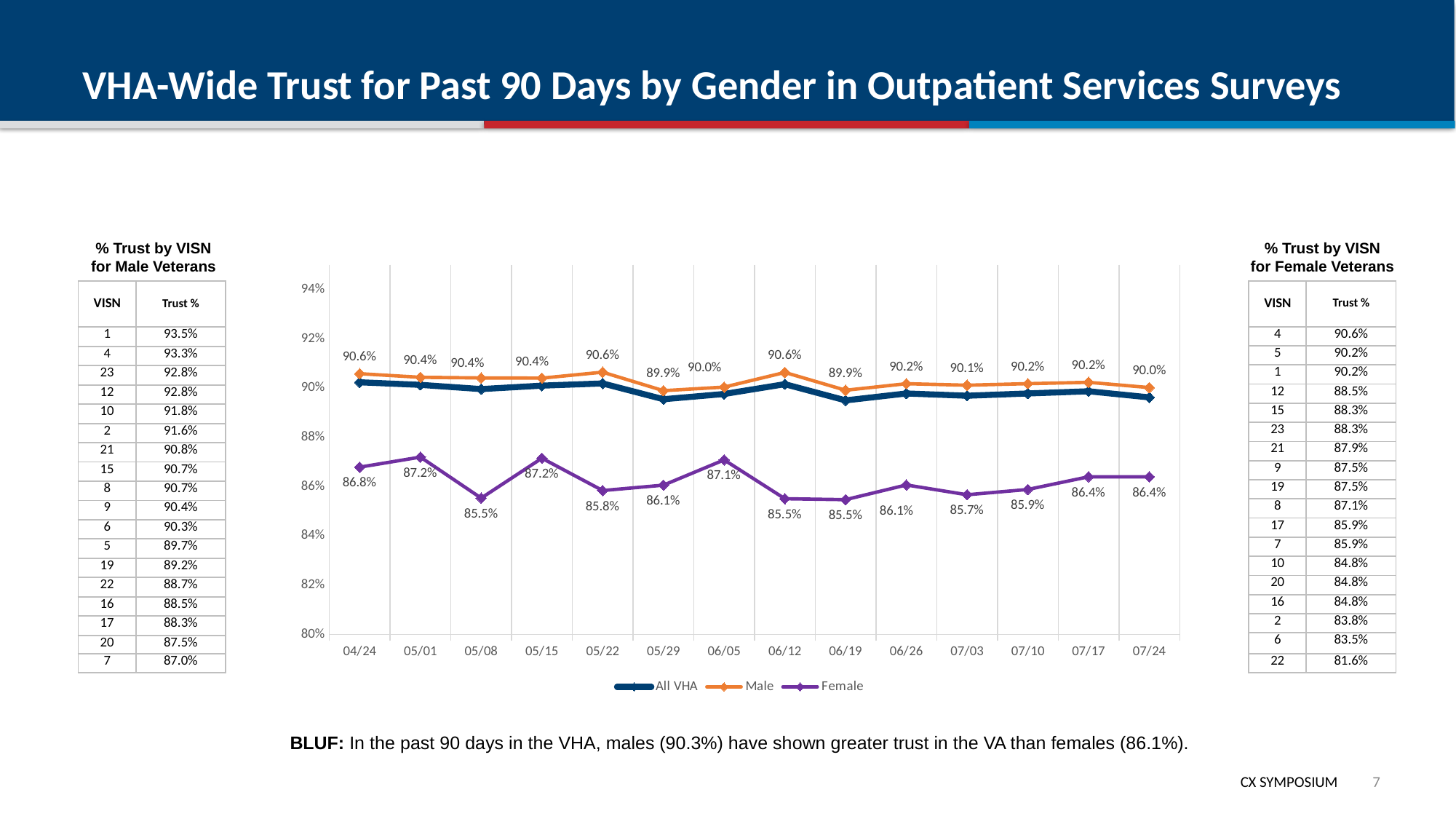
How many series does the chart legend list? 3 What is the Female trust value on 07/24? 86.4% How many dates are plotted along the x axis of the chart? 14 Is the All VHA value on 05/29 greater or less than 90%? less Which series has the higher value on 06/12, Male or Female? Male What is the lowest value shown for the Male series? 89.9% What is the difference between the Male and Female values on 04/24? 3.8 percentage points What type of chart is shown on the slide? Line chart What is the Male trust value on 05/29? 89.9% What is the Male trust value on 04/24? 90.6% Does the Female series rise or fall from 05/01 to 05/08? Fall What is the Female trust value on 06/05? 87.1%